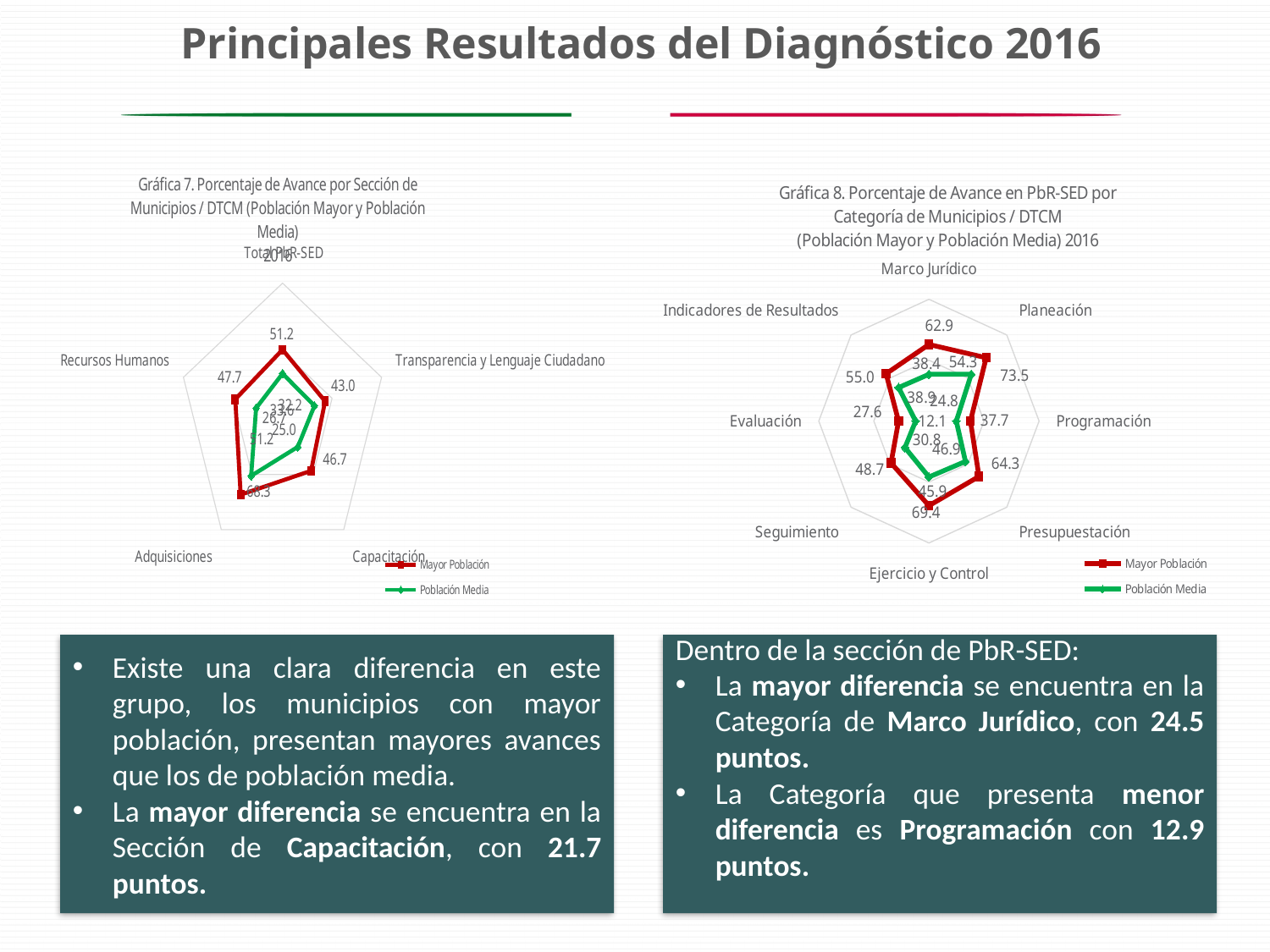
How many series does the legend of Gráfica 7 list? 2 In Gráfica 8, which category has the highest value for Mayor Población? Planeación In Gráfica 7, what is the difference between Mayor Población (46.7) and Población Media (25.0) in Capacitación? 21.7 In Gráfica 8, for Mayor Población, which is larger: Presupuestación or Ejercicio y Control? Ejercicio y Control How many categories (axes) does Gráfica 8 on the right of the slide have? 8 In Gráfica 8, which category has the lowest value for Población Media? Evaluación In Gráfica 7, what is the value for Mayor Población on the Total PbR-SED axis? 51.2 In Gráfica 8, what is the value for Mayor Población in Planeación? 73.5 In Gráfica 7, what is the value for Mayor Población in Capacitación? 46.7 In Gráfica 8, what is the difference between Mayor Población (62.9) and Población Media (38.4) in Marco Jurídico? 24.5 In Gráfica 8, what is the value for Población Media in Evaluación? 12.1 What kind of chart is Gráfica 7 on the left of the slide? Radar chart